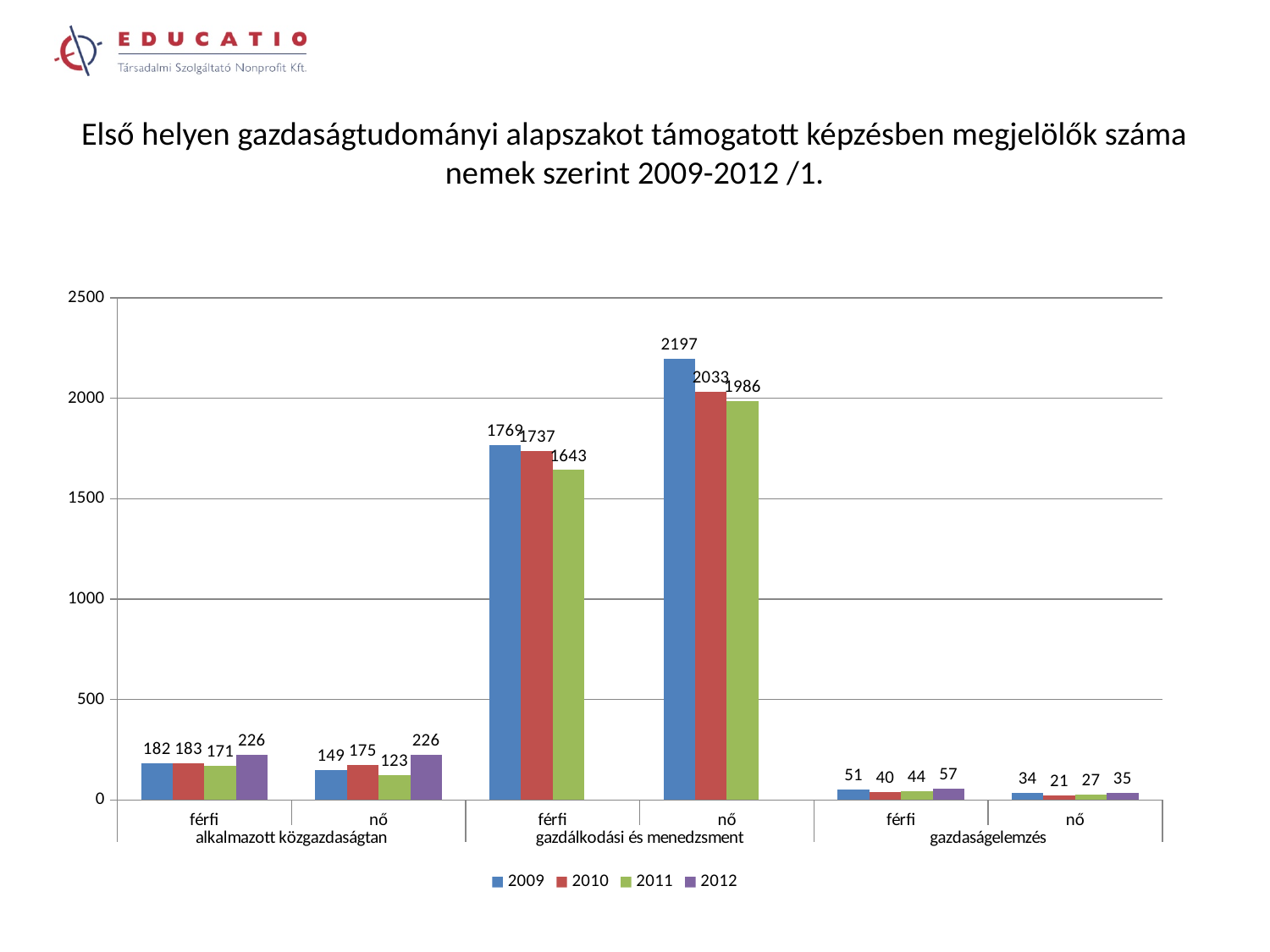
How many series does the legend list? 4 What is the value for 2012 for nő in gazdaságelemzés? 35 Which series has the lowest value for nő in gazdaságelemzés? 2010 What kind of chart is shown on the slide? bar chart What is the difference between the 2009 and 2011 values for nő in gazdálkodási és menedzsment? 211 Which is larger: the 2010 value for férfi in alkalmazott közgazdaságtan or the 2010 value for nő in alkalmazott közgazdaságtan? férfi What is the value for 2011 for férfi in alkalmazott közgazdaságtan? 171 Which series has the highest value for férfi in gazdálkodási és menedzsment? 2009 What is the difference between the 2012 and 2011 values for nő in alkalmazott közgazdaságtan? 103 Is the 2011 value for férfi in gazdálkodási és menedzsment greater or less than 1500? greater What is the value for 2009 for nő in gazdálkodási és menedzsment? 2197 Which colour represents the 2012 series in the legend? purple